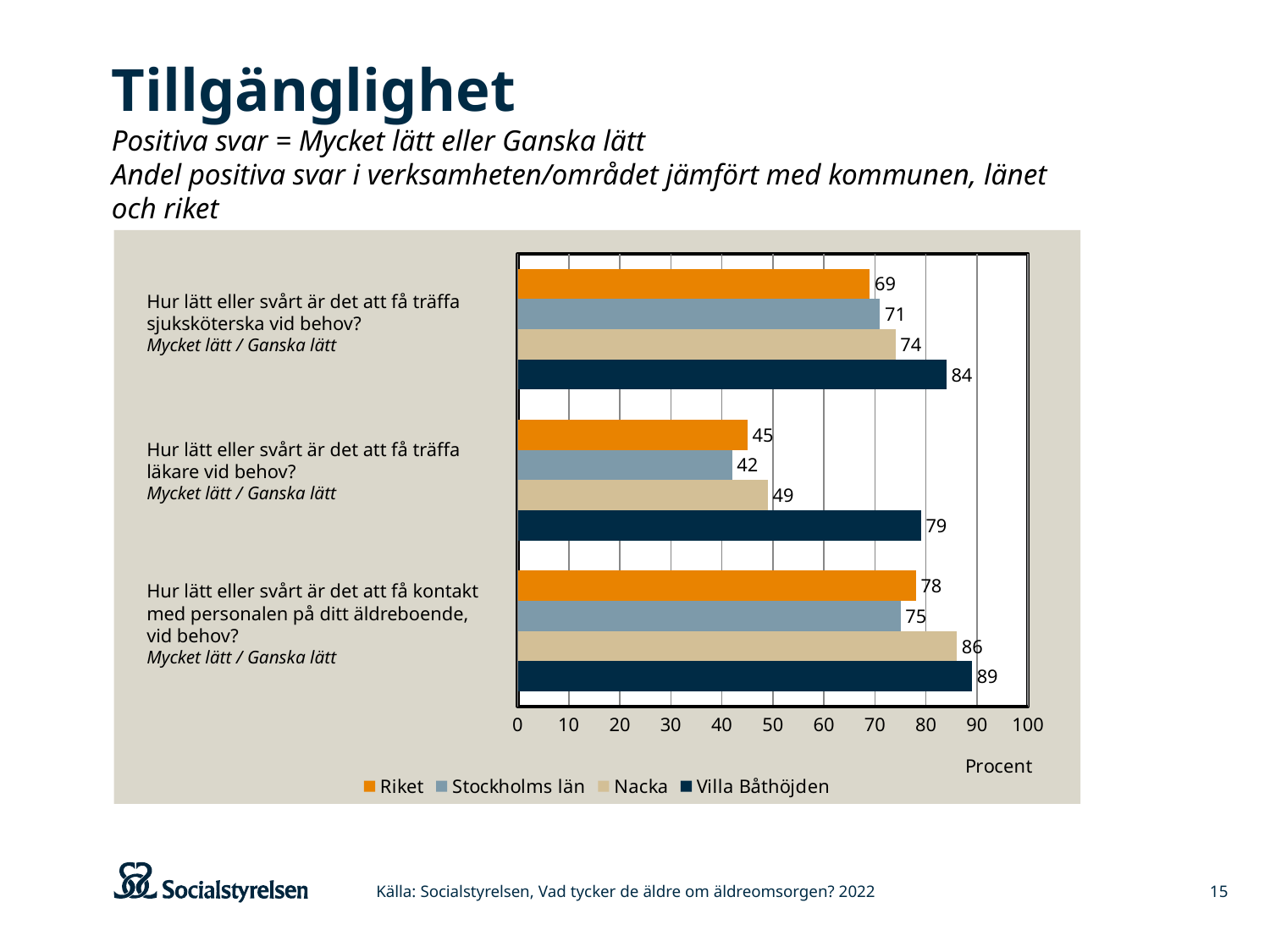
What is the difference between Villa Båthöjden and Riket on the question about meeting a doctor when needed? 34 Which series has the lowest value on the question about getting in contact with staff at the care home? Stockholms län Is the value for Nacka on the question about meeting a doctor when needed greater or less than 50? less What is the value for Villa Båthöjden on the question about meeting a nurse when needed ("Hur lätt eller svårt är det att få träffa sjuksköterska vid behov?")? 84 Which series has the highest value on the question about meeting a doctor when needed? Villa Båthöjden What is the value for Stockholms län on the question about meeting a doctor when needed ("Hur lätt eller svårt är det att få träffa läkare vid behov?")? 42 What kind of chart is shown on the slide? Bar chart How many questions (categories) are shown in the chart? 3 How many series does the legend list? 4 What is the value for Nacka on the question about getting in contact with staff at the care home ("Hur lätt eller svårt är det att få kontakt med personalen på ditt äldreboende, vid behov?")? 86 What unit is shown on the x axis of the chart? Procent Which is larger on the question about meeting a nurse when needed: Riket or Nacka? Nacka